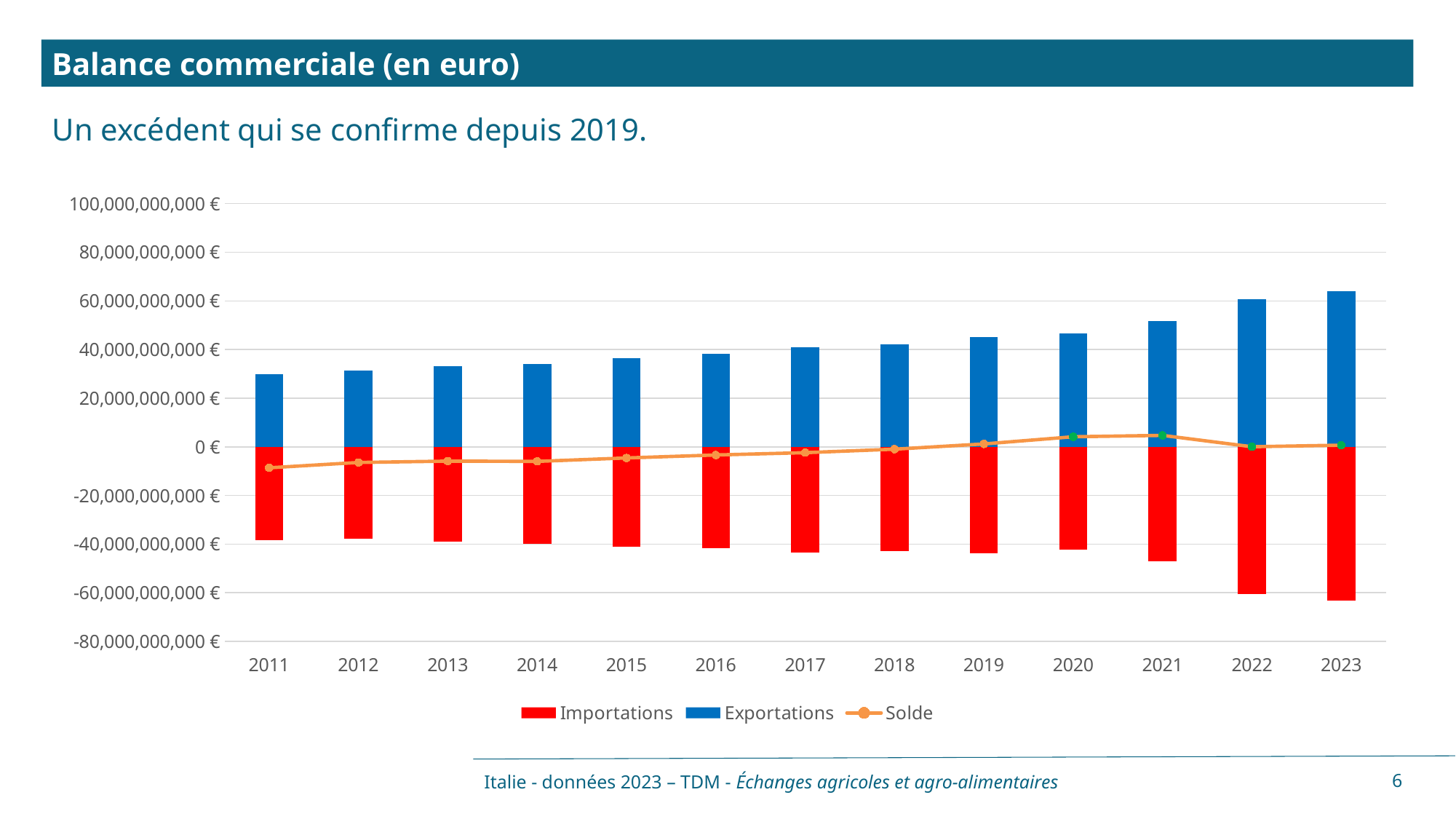
Do the Exportations values rise or fall from 2011 to 2023? rise Is the Solde value for 2011 greater or less than 0 €? less How many series does the chart legend list? 3 Is the Exportations value for 2023 greater or less than 60,000,000,000 €? greater Which year has the highest Exportations value? 2023 Which colour represents Importations in the chart? red Is the Exportations value for 2011 greater or less than 40,000,000,000 €? less How many years are shown on the x axis of the chart? 13 Which year has the lowest Exportations value? 2011 Which year has the larger Exportations value, 2015 or 2022? 2022 What kind of chart is shown on the slide? bar chart with a line